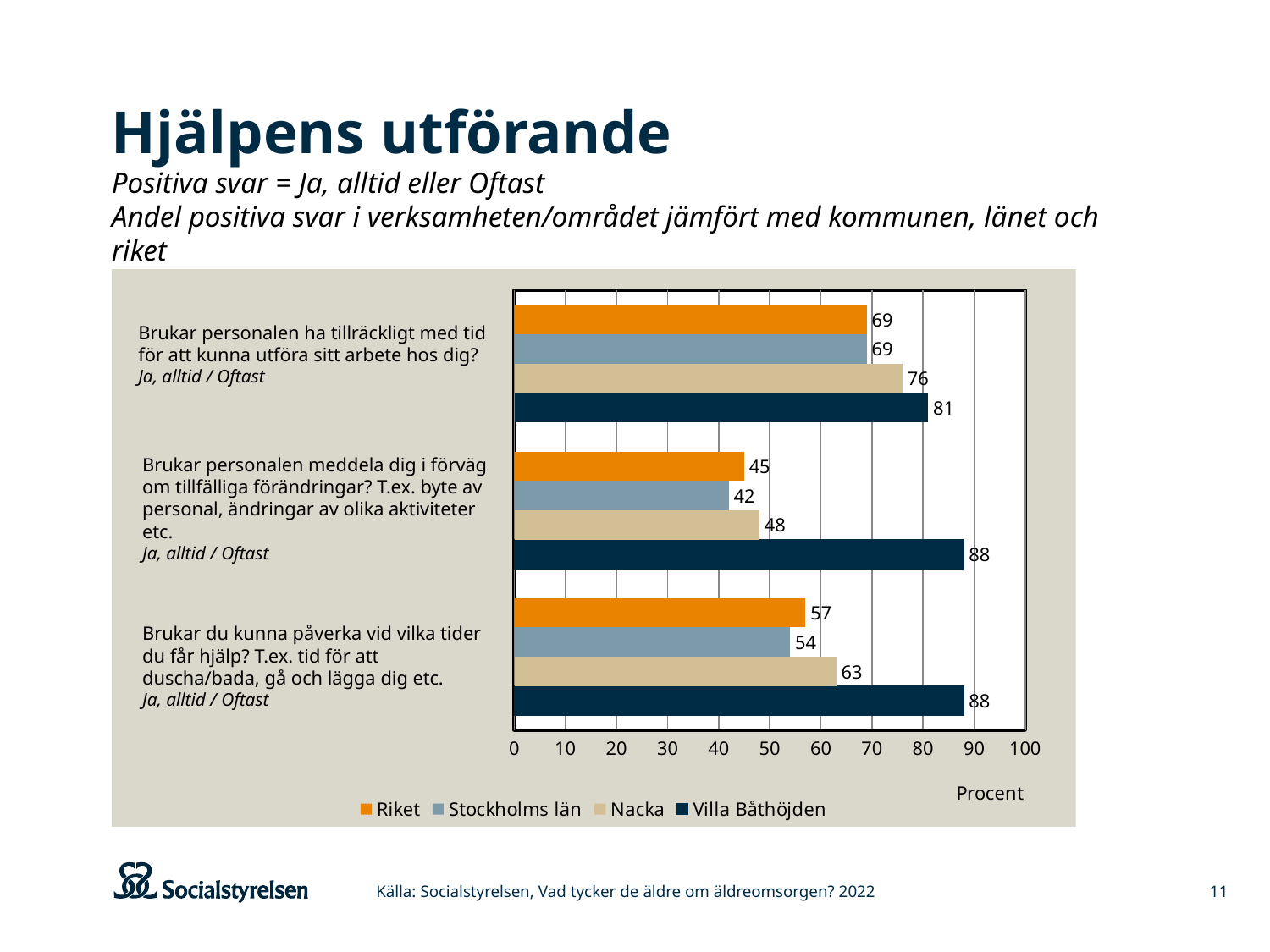
What is the difference between Villa Båthöjden and Riket for the question 'Brukar personalen meddela dig i förväg om tillfälliga förändringar?'? 43 What type of chart is shown on the slide? Bar chart Which series has the lowest value for the question 'Brukar du kunna påverka vid vilka tider du får hjälp?'? Stockholms län What is the value for Nacka for the question 'Brukar du kunna påverka vid vilka tider du får hjälp?'? 63 Which is larger for the question 'Brukar personalen ha tillräckligt med tid för att kunna utföra sitt arbete hos dig?': Nacka or Riket? Nacka How many series does the legend list? 4 Which series has the highest value for the question 'Brukar personalen meddela dig i förväg om tillfälliga förändringar?'? Villa Båthöjden What unit label is shown below the x axis of the chart? Procent What is the value for Riket for the question 'Brukar du kunna påverka vid vilka tider du får hjälp?'? 57 What is the value for Stockholms län for the question 'Brukar personalen meddela dig i förväg om tillfälliga förändringar?'? 42 How many question categories are shown on the chart? 3 What is the value for Villa Båthöjden for the question 'Brukar personalen ha tillräckligt med tid för att kunna utföra sitt arbete hos dig?'? 81